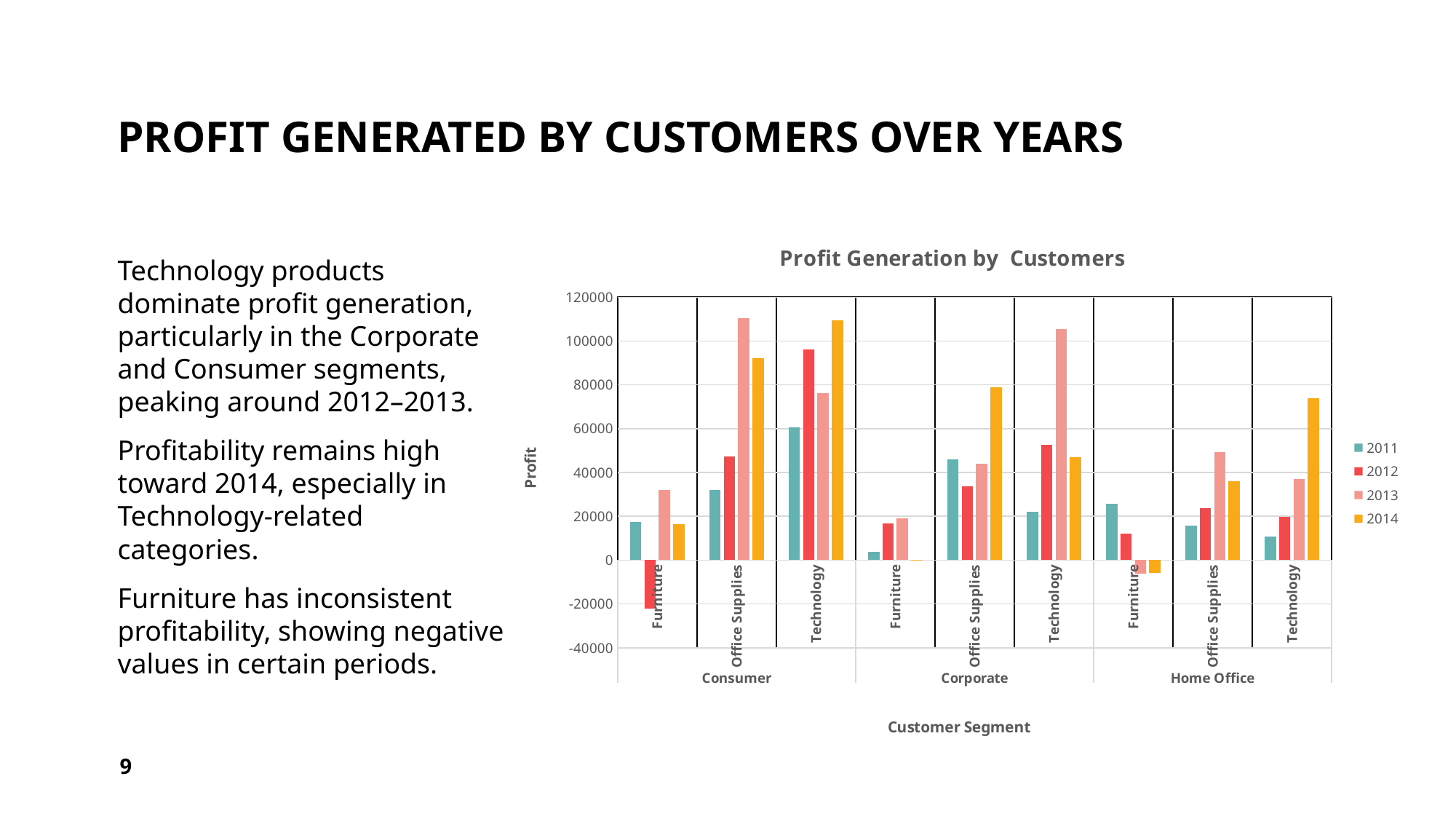
For Technology in the Corporate segment, which year has the highest profit? 2013 How many customer segments are shown along the x axis of the chart? 3 What kind of chart is shown on the slide? bar chart For Furniture in the Consumer segment, which year has the lowest profit? 2012 For Technology in the Home Office segment, do the values rise or fall from 2011 to 2014? rise Is the 2012 value for Furniture in the Consumer segment greater or less than 0? less How many series does the legend of the chart list? 4 In the Corporate segment, which is larger for 2014: Office Supplies or Technology? Office Supplies What is the title of the chart? Profit Generation by Customers For Technology in the Consumer segment, which is larger: the 2012 value or the 2014 value? 2014 Is the 2013 value for Office Supplies in the Home Office segment greater or less than 40000? greater Is the 2013 value for Office Supplies in the Consumer segment greater or less than 100000? greater